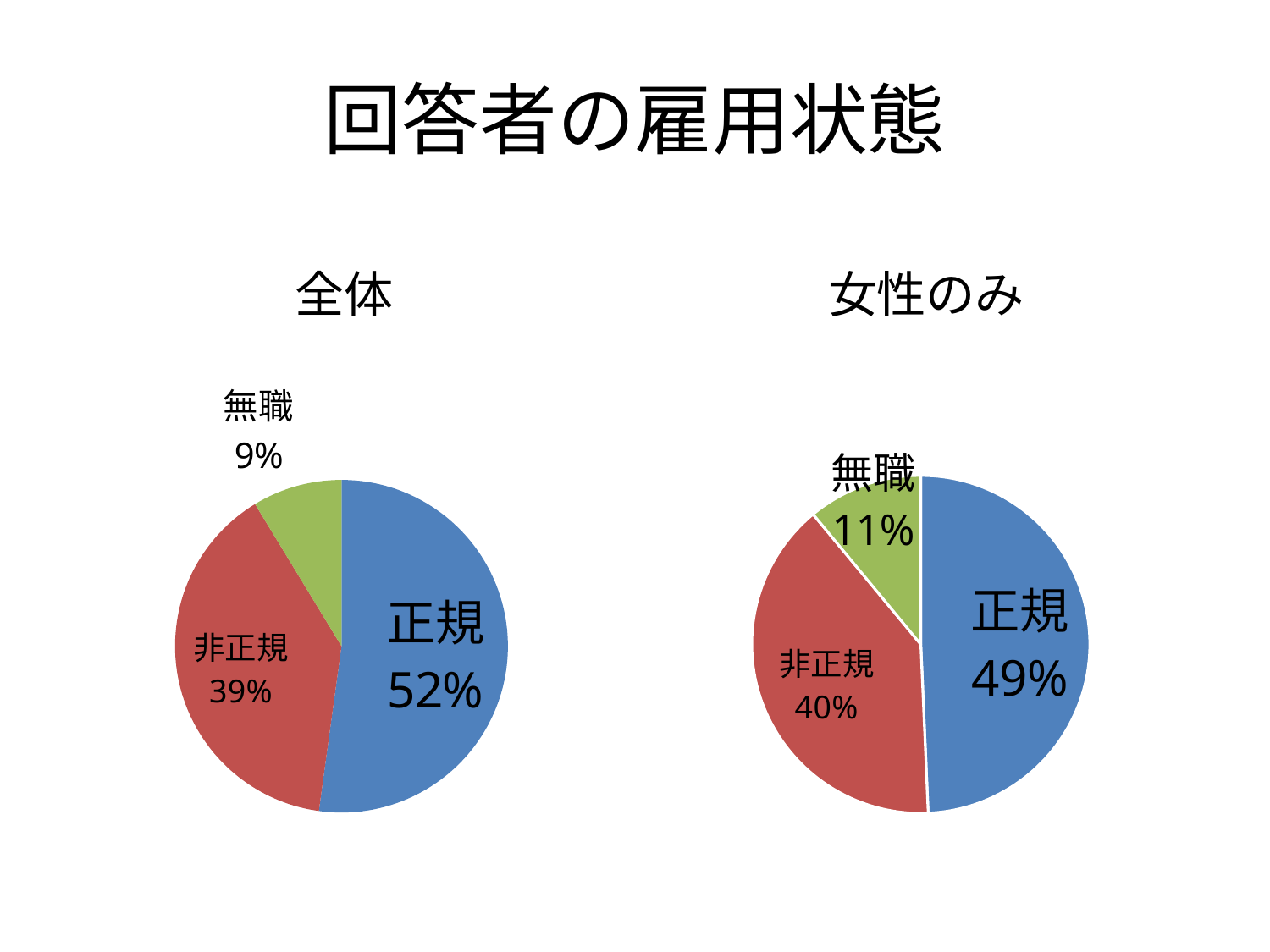
In the 全体 pie chart, which category has the largest slice? 正規 In the 女性のみ pie chart, which category has the smallest slice? 無職 How many categories does the 女性のみ pie chart show? 3 In the 女性のみ pie chart, what share is labelled for 正規? 49% Which is larger: the 無職 share in the 全体 chart or the 無職 share in the 女性のみ chart? 女性のみ In the 全体 pie chart, what share is labelled for 無職? 9% In the 女性のみ pie chart, what share is labelled for 無職? 11% What kind of chart is used for 全体? Pie chart In the 全体 pie chart, what is the difference between the 正規 and 非正規 shares? 13%